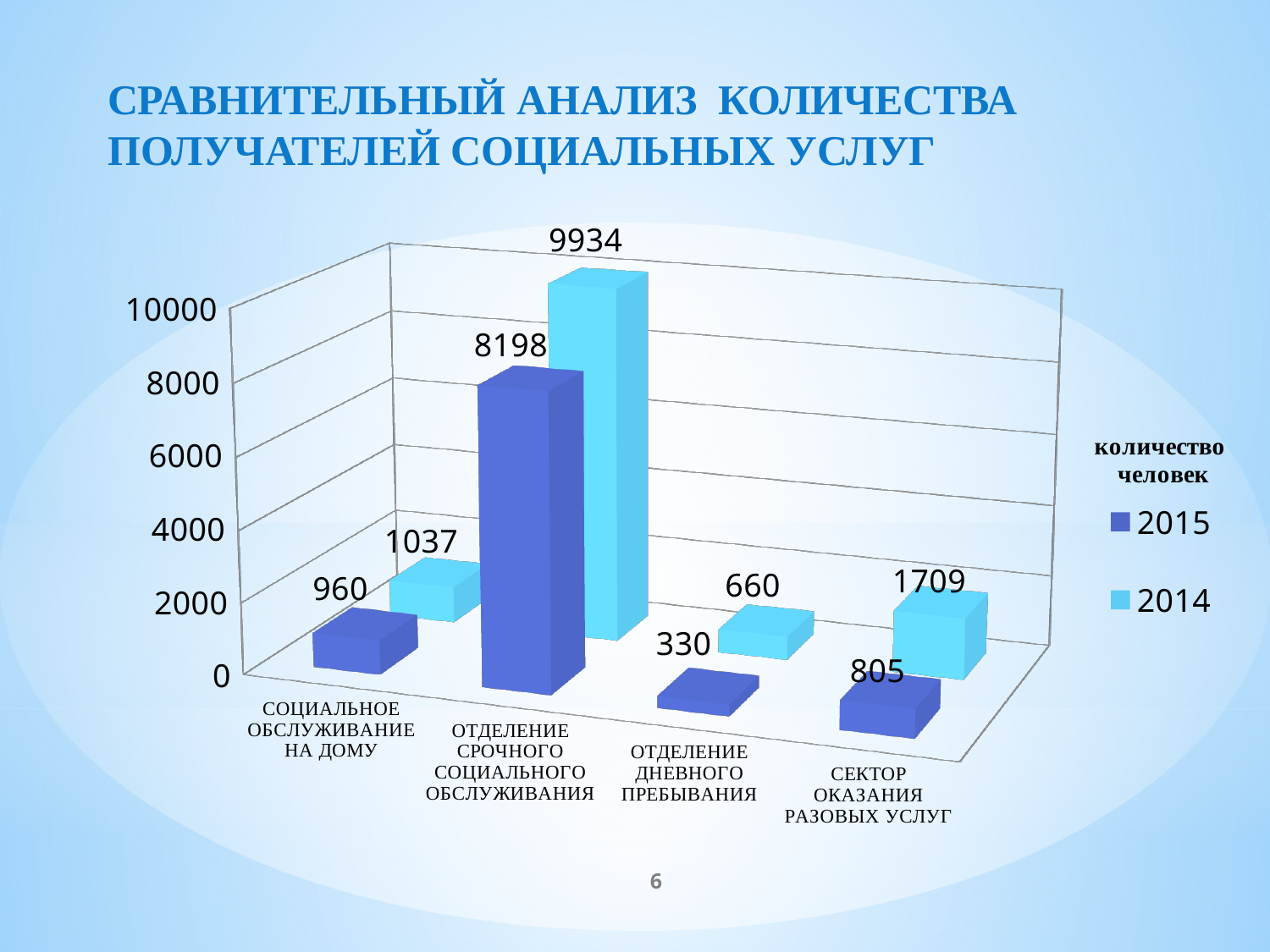
What is the title of the legend? количество человек What is the 2014 value for Социальное обслуживание на дому? 1037 Which category has the highest 2014 value? Отделение срочного социального обслуживания What is the 2014 value for Сектор оказания разовых услуг? 1709 What is the 2015 value for Отделение срочного социального обслуживания? 8198 Which is larger for Сектор оказания разовых услуг: the 2015 value or the 2014 value? 2014 What is the 2015 value for Отделение дневного пребывания? 330 How many series does the legend list? 2 What kind of chart is shown on the slide? Bar chart What is the difference between the 2014 and 2015 values for Отделение срочного социального обслуживания? 1736 Which category has the lowest 2015 value? Отделение дневного пребывания How many categories are shown on the x axis? 4